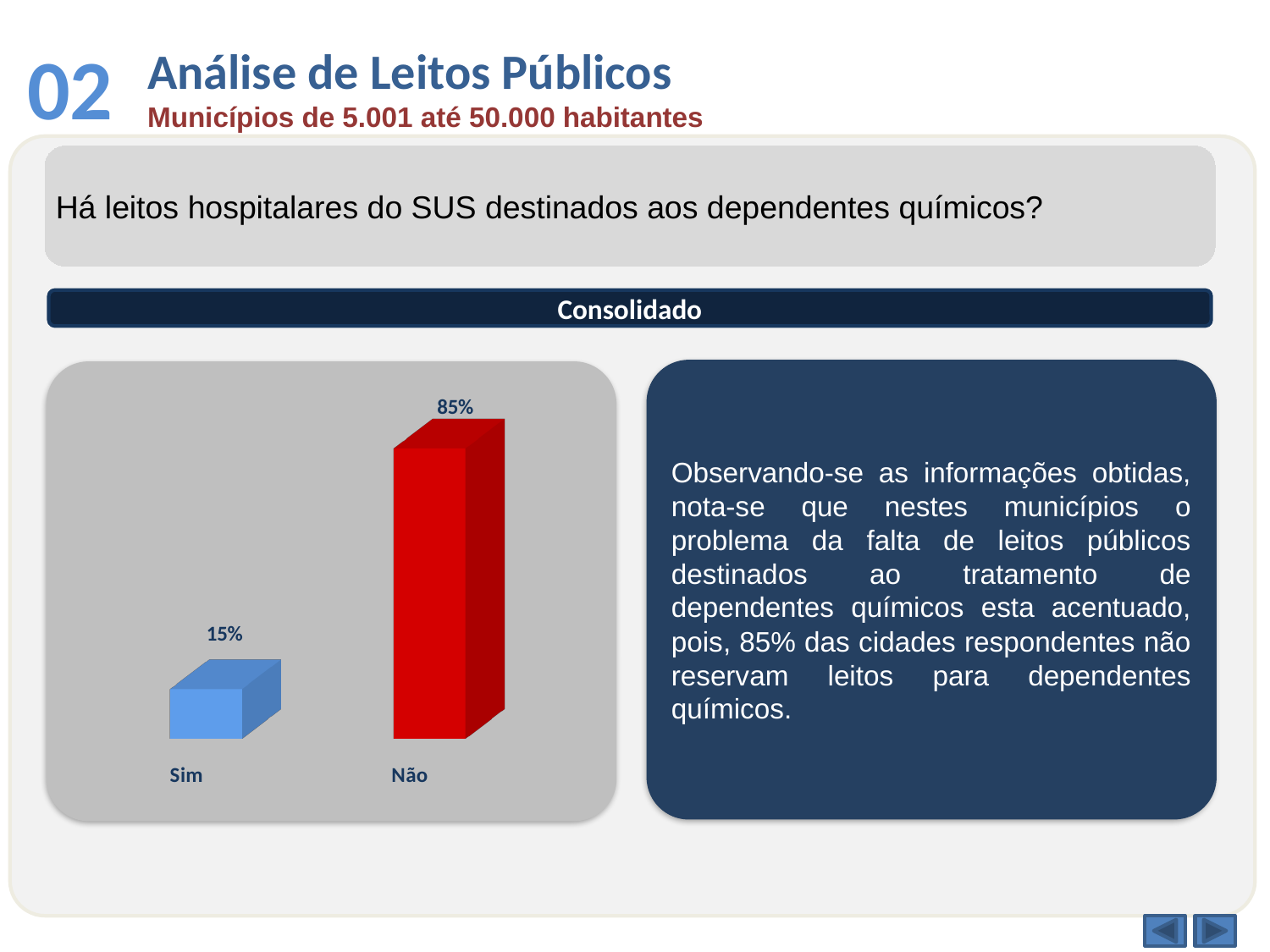
What colour is the bar for "Não"? Red Which category has the lowest value? Sim Which is larger, the value for "Sim" or the value for "Não"? Não How many categories are shown in the chart? 2 What is the total of the two values shown in the chart? 100% What kind of chart is shown on the slide? Bar chart What is the heading shown in the dark bar above the chart? Consolidado What is the value for "Sim"? 15% Which category has the highest value? Não What is the value for "Não"? 85% What is the difference between the values for "Não" and "Sim"? 70%